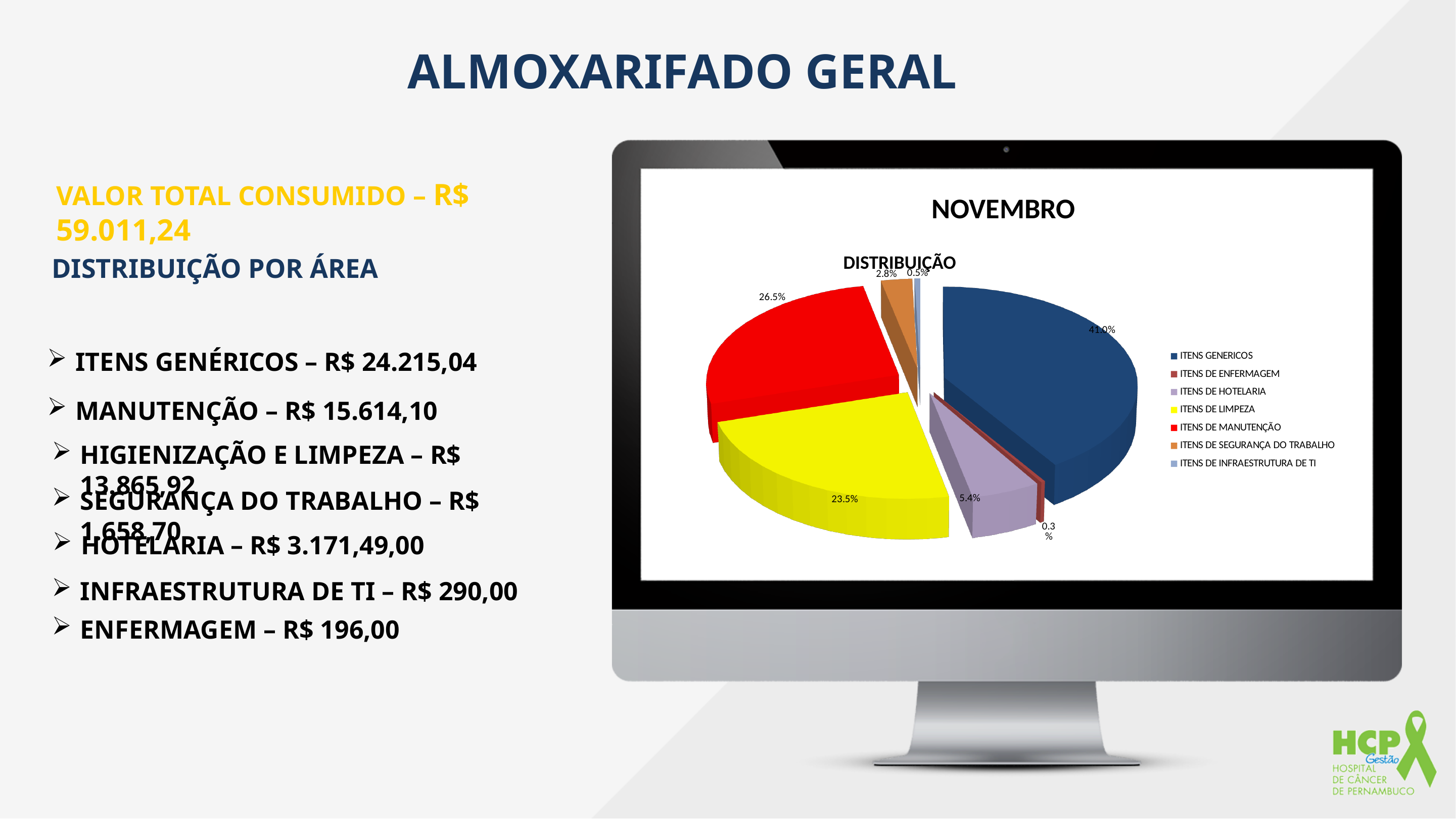
How many categories does the pie chart legend list? 7 Which slice is larger in the pie chart, ITENS DE HOTELARIA or ITENS DE SEGURANÇA DO TRABALHO? ITENS DE HOTELARIA What percentage of the pie chart does ITENS DE HOTELARIA represent? 5.4% What is the difference in percentage points between ITENS DE MANUTENÇÃO and ITENS DE LIMPEZA in the pie chart? 3.0 Which category has the smallest slice of the pie chart? ITENS DE ENFERMAGEM What type of chart is shown on the slide? Pie chart What percentage of the pie chart does ITENS DE LIMPEZA represent? 23.5% What percentage of the pie chart does ITENS DE MANUTENÇÃO represent? 26.5% What percentage of the pie chart does ITENS DE SEGURANÇA DO TRABALHO represent? 2.8% What percentage of the pie chart does ITENS GENERICOS represent? 41.0% Which category has the largest slice of the pie chart? ITENS GENERICOS